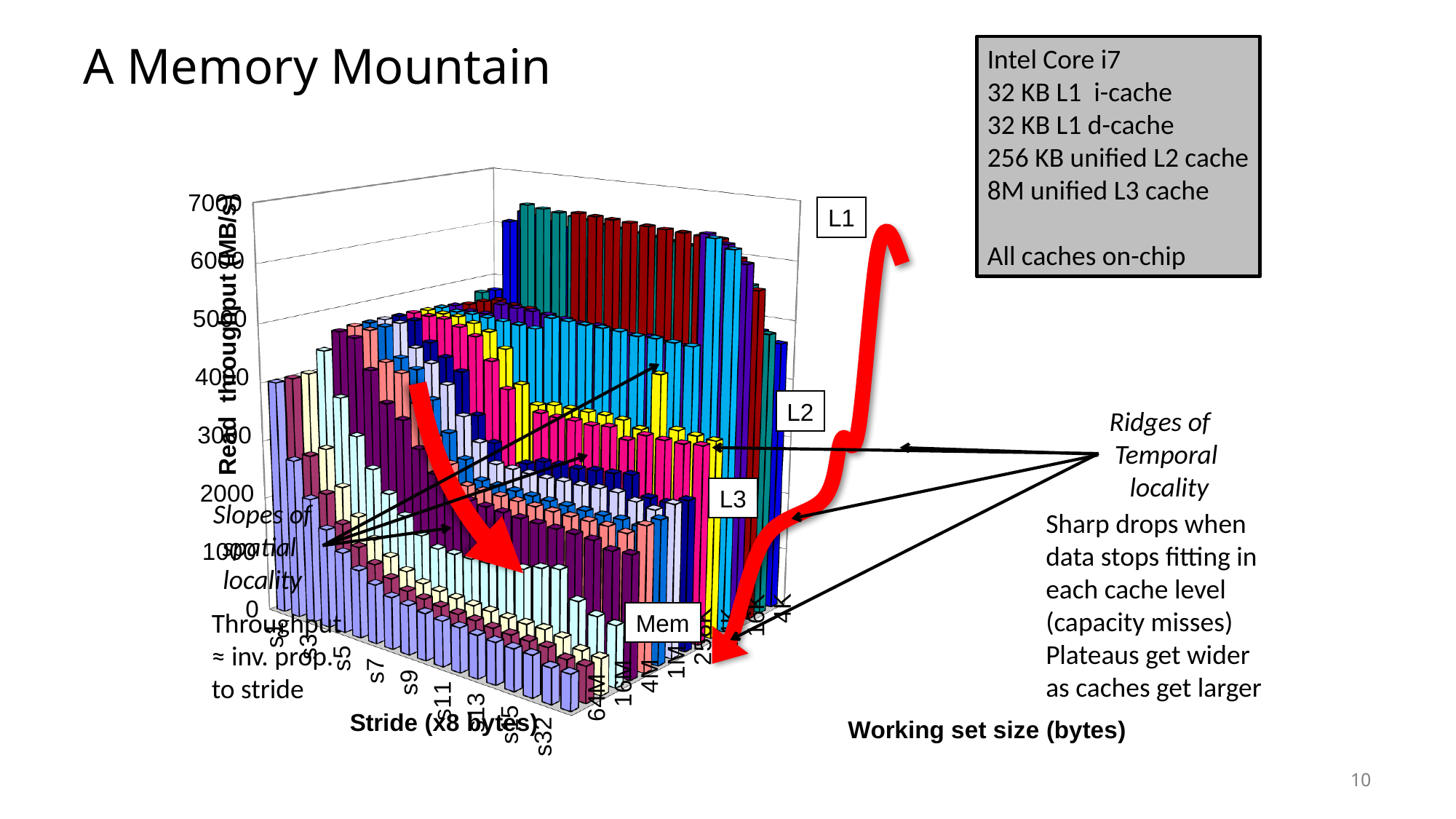
How many working set size labels are shown along the working set size axis? 8 Is the read throughput for stride s1 with a 64M working set greater or less than 2000? greater Which has the higher read throughput: stride s1 with a 4K working set, or stride s32 with a 64M working set? stride s1 with a 4K working set What is the label of the vertical axis of the chart? Read throughput (MB/s) As the working set size increases from 4K to 64M for a fixed stride, does read throughput rise or fall? fall Is the read throughput for stride s32 with a 64M working set greater or less than 2000? less What kind of chart is shown on the slide? 3D bar chart How many stride labels are shown along the stride axis? 9 What is the highest tick value shown on the read throughput axis? 7000